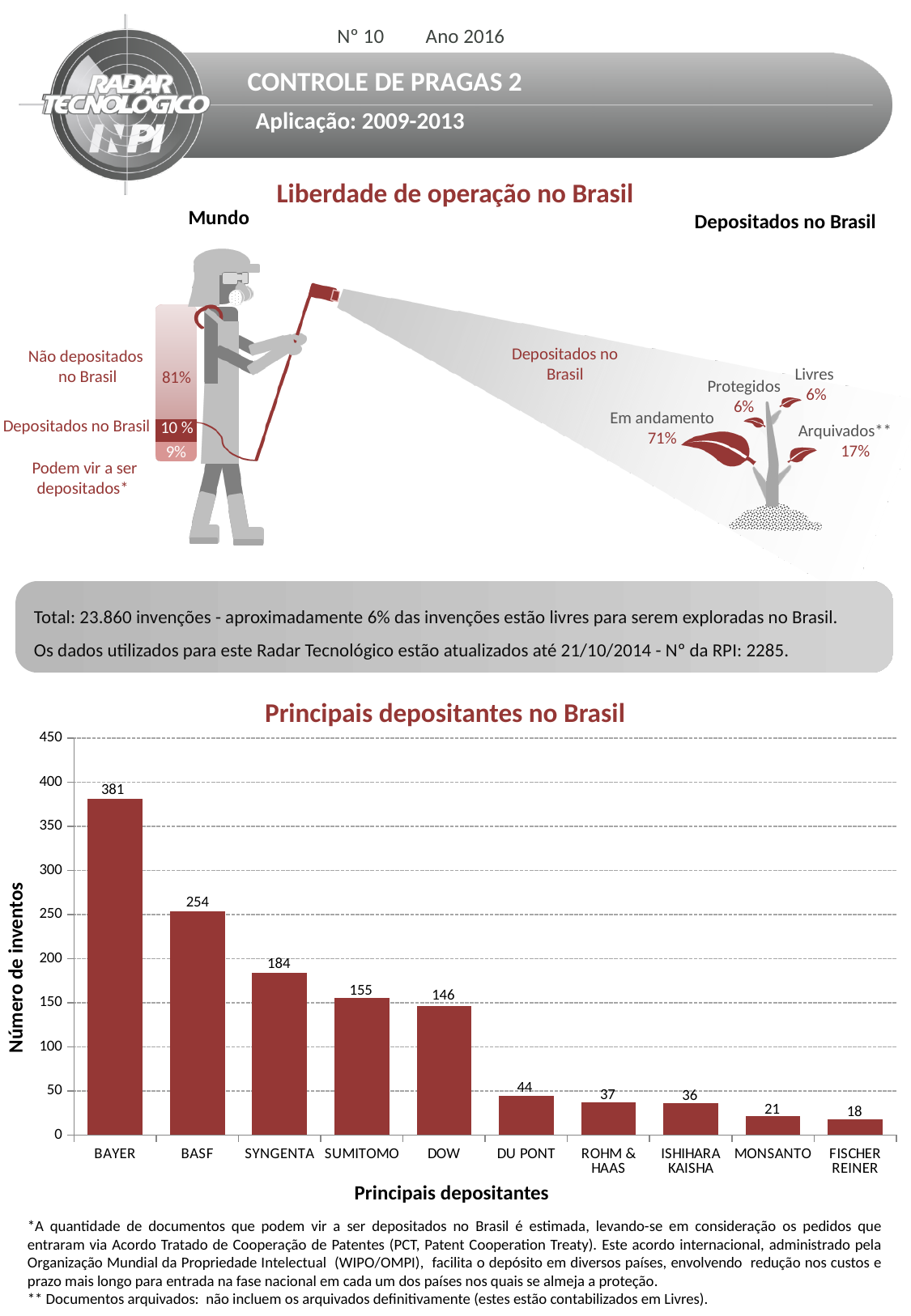
In the 'Principais depositantes no Brasil' chart, which depositor has the highest number of inventions? BAYER In the 'Principais depositantes no Brasil' chart, is the value for DU PONT greater or less than 50? less How many depositors are shown in the 'Principais depositantes no Brasil' chart? 10 In the 'Principais depositantes no Brasil' chart, which is larger, the value for SYNGENTA or the value for DOW? SYNGENTA What is the y-axis label of the 'Principais depositantes no Brasil' chart? Número de inventos In the 'Principais depositantes no Brasil' chart, what is the difference between the values for BAYER and BASF? 127 What kind of chart is 'Principais depositantes no Brasil'? bar chart In the 'Principais depositantes no Brasil' chart, which depositor has the lowest number of inventions? FISCHER REINER In the 'Principais depositantes no Brasil' chart, what is the value for BAYER? 381 In the 'Principais depositantes no Brasil' chart, what is the value for SUMITOMO? 155 In the 'Principais depositantes no Brasil' chart, do the values rise or fall from left to right along the x axis? fall In the 'Principais depositantes no Brasil' chart, what is the value for ROHM & HAAS? 37